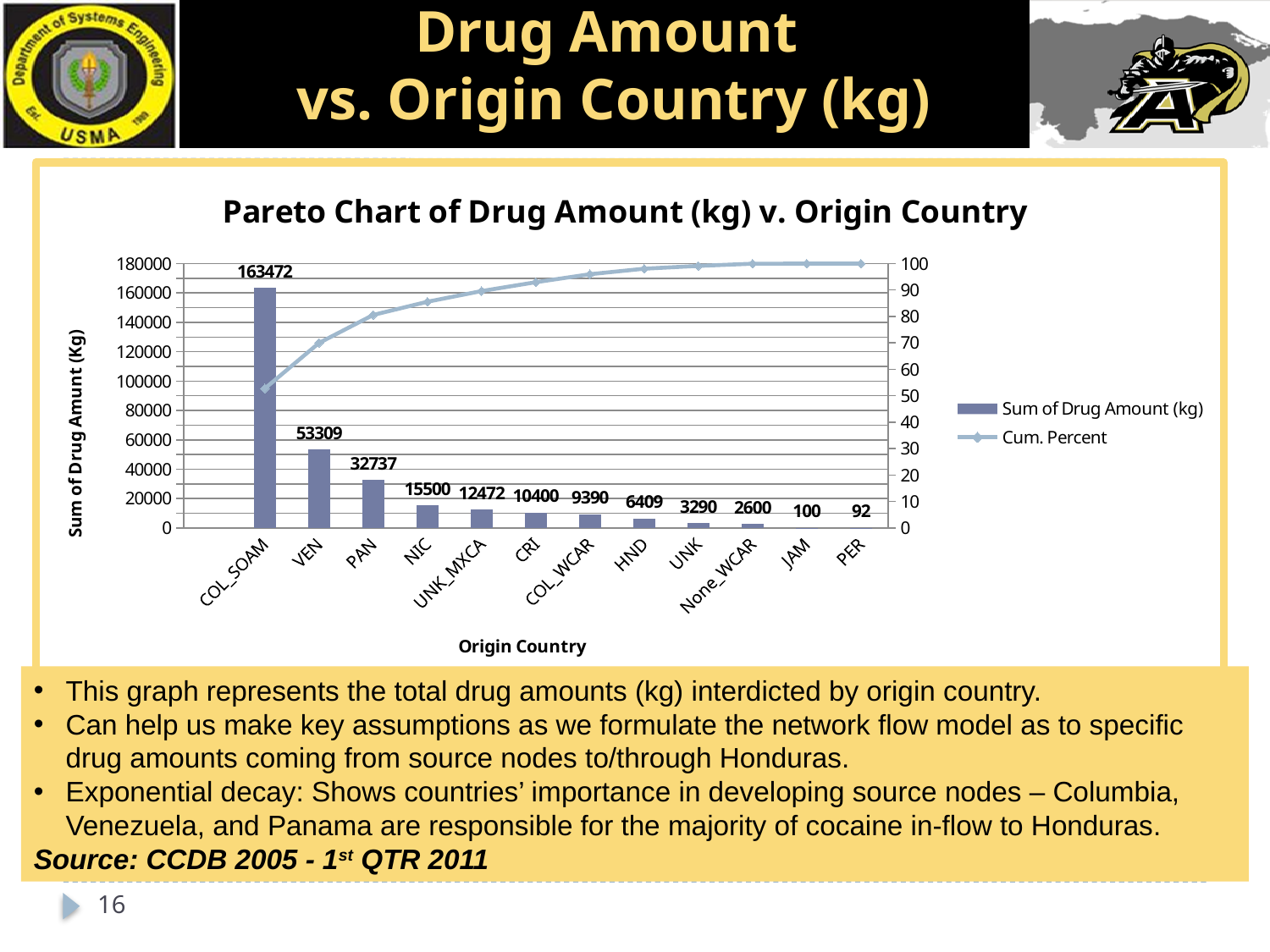
How many series does the legend list? 2 What is the Sum of Drug Amount (kg) for COL_SOAM? 163472 What is the Sum of Drug Amount (kg) for VEN? 53309 Is the Cum. Percent value for COL_SOAM greater or less than 50? greater Which origin country has the lowest Sum of Drug Amount (kg)? PER How many origin countries are shown on the x axis? 12 Which origin country has the highest Sum of Drug Amount (kg)? COL_SOAM Do the Sum of Drug Amount (kg) bars rise or fall from left to right along the x axis? fall What is the Sum of Drug Amount (kg) for HND? 6409 What is the difference between the Sum of Drug Amount (kg) for VEN and PAN? 20572 What is the title of the chart? Pareto Chart of Drug Amount (kg) v. Origin Country Which has a larger Sum of Drug Amount (kg), NIC or CRI? NIC